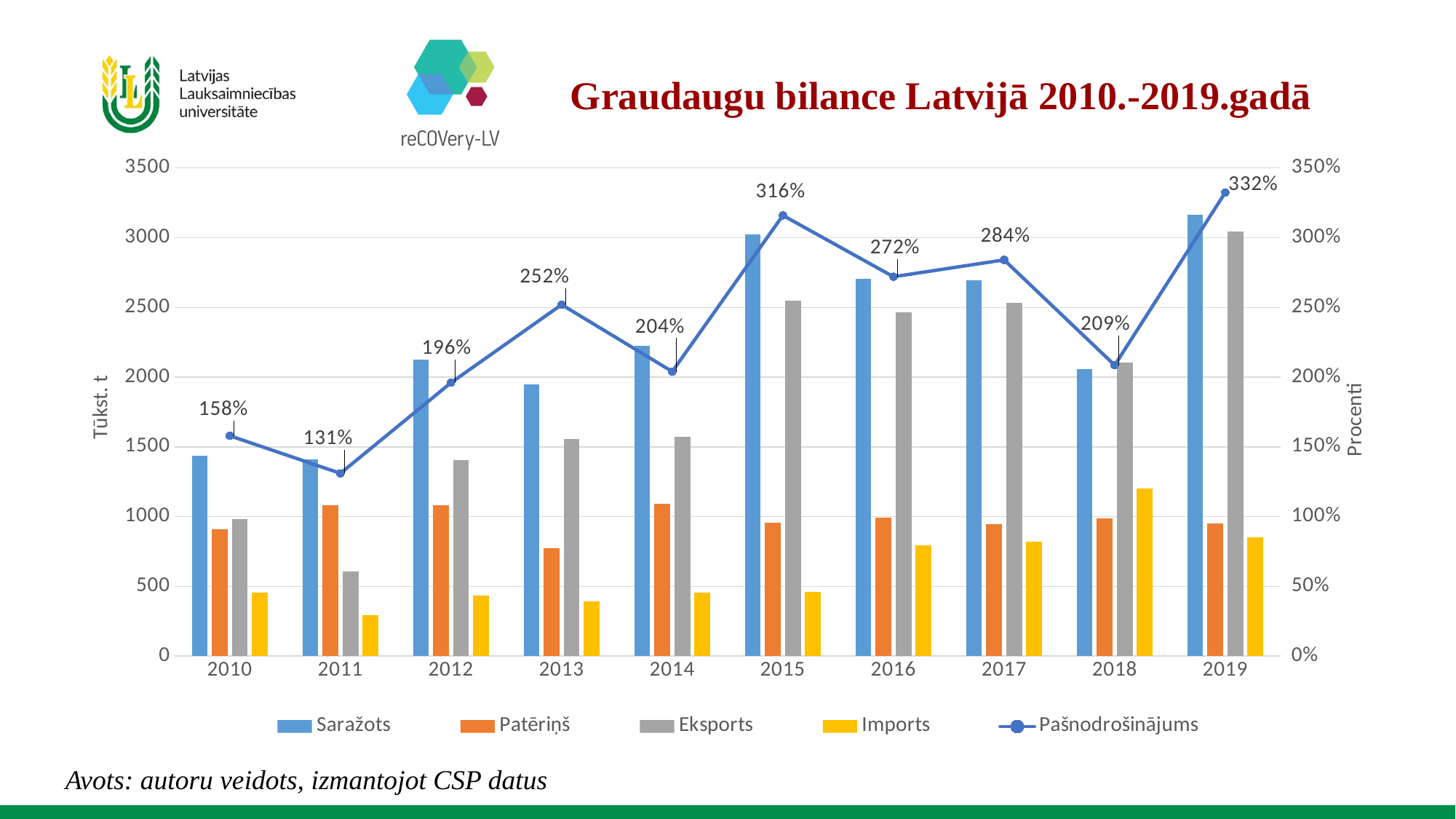
What is the label of the right-hand vertical axis? Procenti What kind of chart is shown on the slide? A combination bar and line chart By how many percentage points does Pašnodrošinājums in 2019 exceed that in 2018? 123 percentage points In which year is Pašnodrošinājums lowest? 2011 In which year is Pašnodrošinājums highest? 2019 How many years are shown on the x axis? 10 What is the Pašnodrošinājums value for 2010? 158% How many series does the legend list? 5 Which year has the higher Pašnodrošinājums value, 2013 or 2014? 2013 What is the Pašnodrošinājums value for 2015? 316% Is the Saražots value for 2019 greater or less than 3000? greater Is the Eksports value for 2011 greater or less than 1000? less